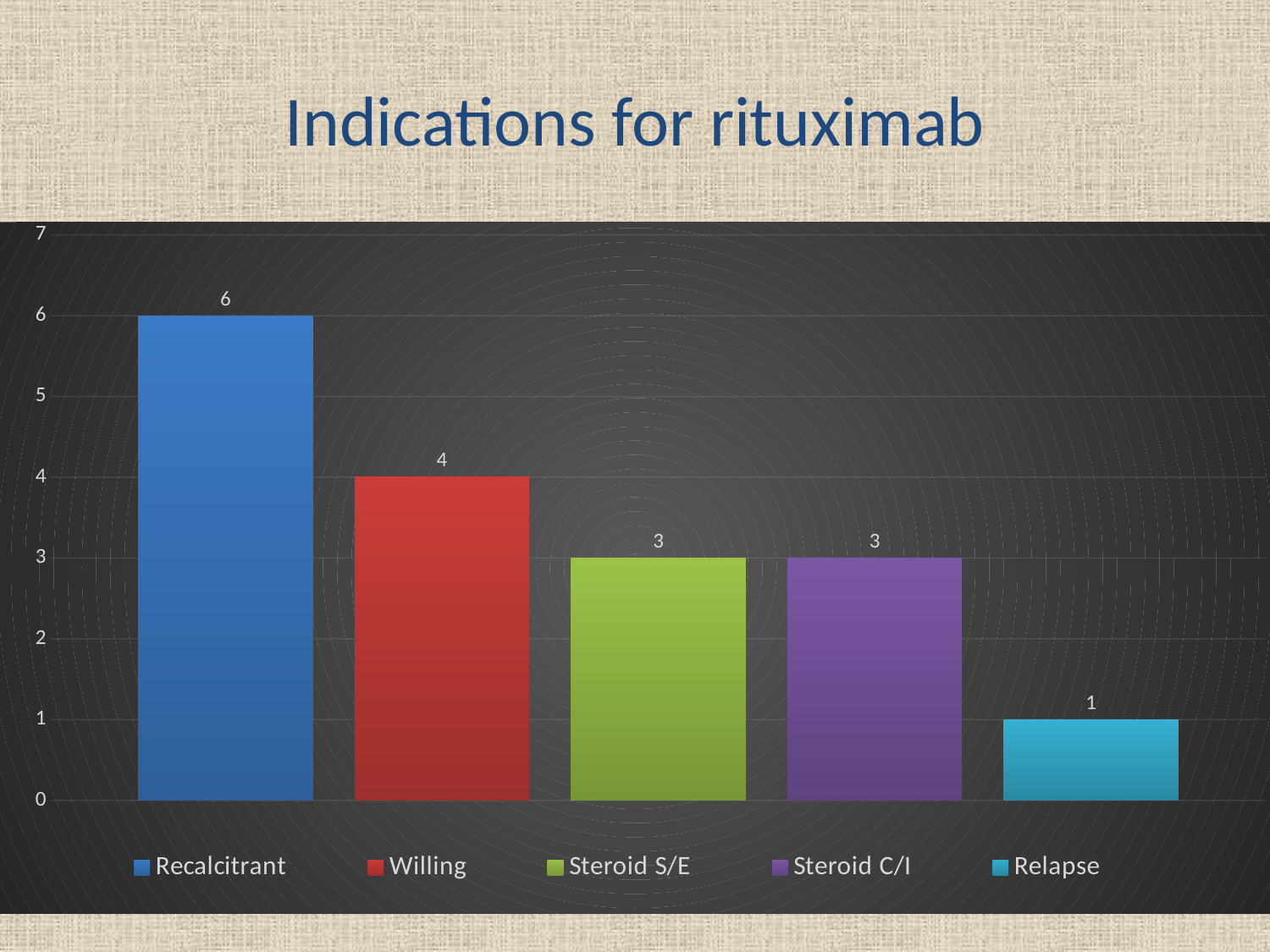
Which indication has the highest value? Recalcitrant Is the value for Recalcitrant greater or less than 5? greater How many indications are shown in the chart? 5 What is the value for Steroid S/E? 3 What is the value for Relapse? 1 What is the title of the chart? Indications for rituximab What is the value for Willing? 4 Which indication has the lowest value? Relapse What is the difference between the values for Recalcitrant and Willing? 2 What is the value for Recalcitrant? 6 Which is larger, the value for Willing or the value for Steroid C/I? Willing What kind of chart is shown on the slide? Bar chart